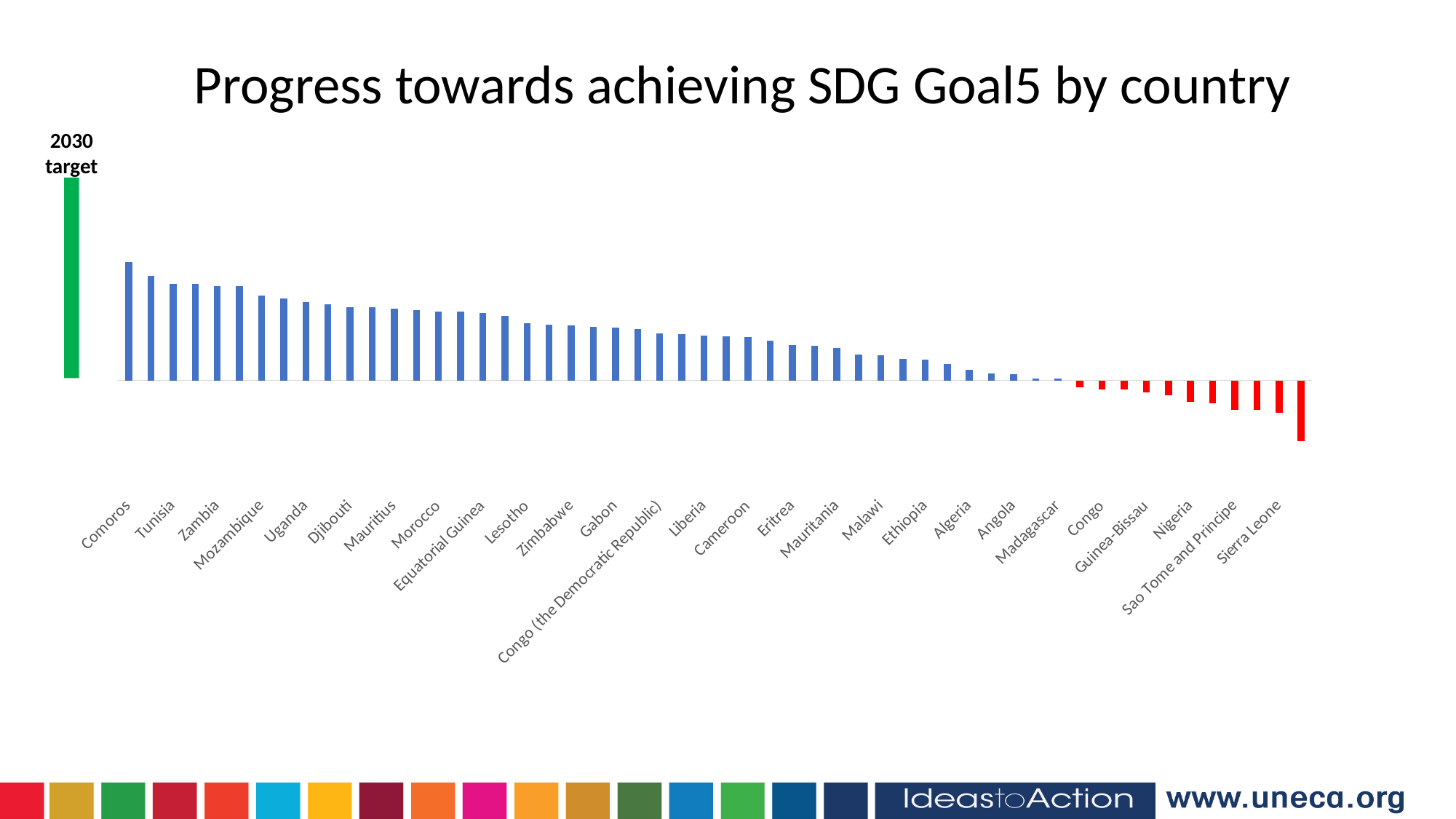
Is the bar for Nigeria above or below the baseline? below Which has the larger value, Uganda or Ethiopia? Uganda Do the values rise or fall moving from left to right along the x axis? fall Which has the larger value, Comoros or Tunisia? Comoros What is the title of the chart? Progress towards achieving SDG Goal5 by country Which country has the highest value in the chart? Comoros What kind of chart is shown on the slide? bar chart What colour are the bars for countries with negative values? red